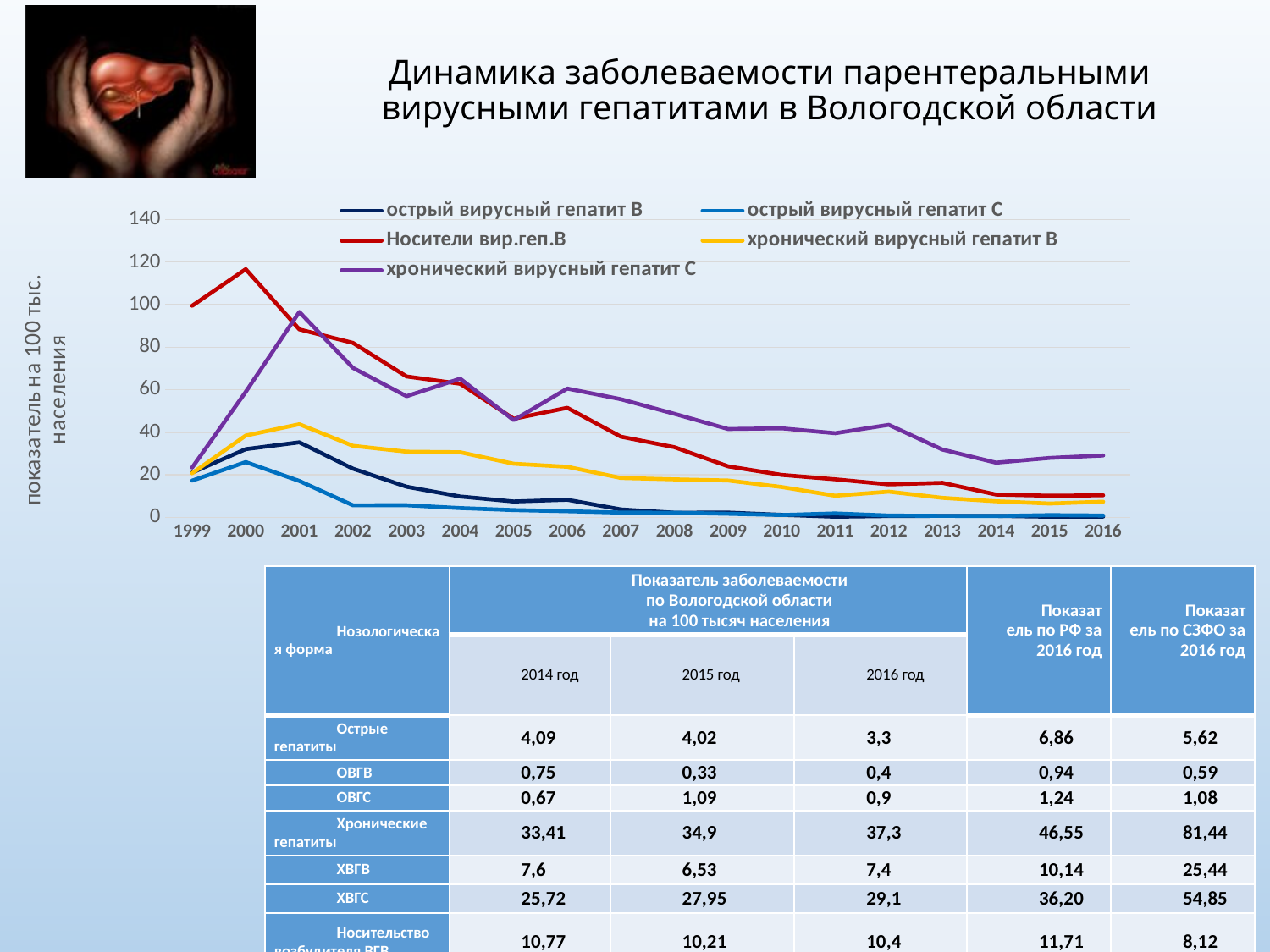
In which year does the хронический вирусный гепатит C series reach its highest value? 2001 Is the value for Носители вир.геп.B in 2016 greater or less than 20? less In which year does the Носители вир.геп.B series reach its highest value? 2000 Is the value for хронический вирусный гепатит C in 2001 greater or less than 100? less How many series does the chart legend list? 5 Which series has the highest value in 2016? хронический вирусный гепатит C What kind of chart is shown on the slide? line chart Is the value for Носители вир.геп.B in 2000 greater or less than 100? greater Does the Носители вир.геп.B series rise or fall overall from 1999 to 2016? fall How many years are shown along the x axis of the chart? 18 In 2000, which is larger: Носители вир.геп.B or хронический вирусный гепатит C? Носители вир.геп.B